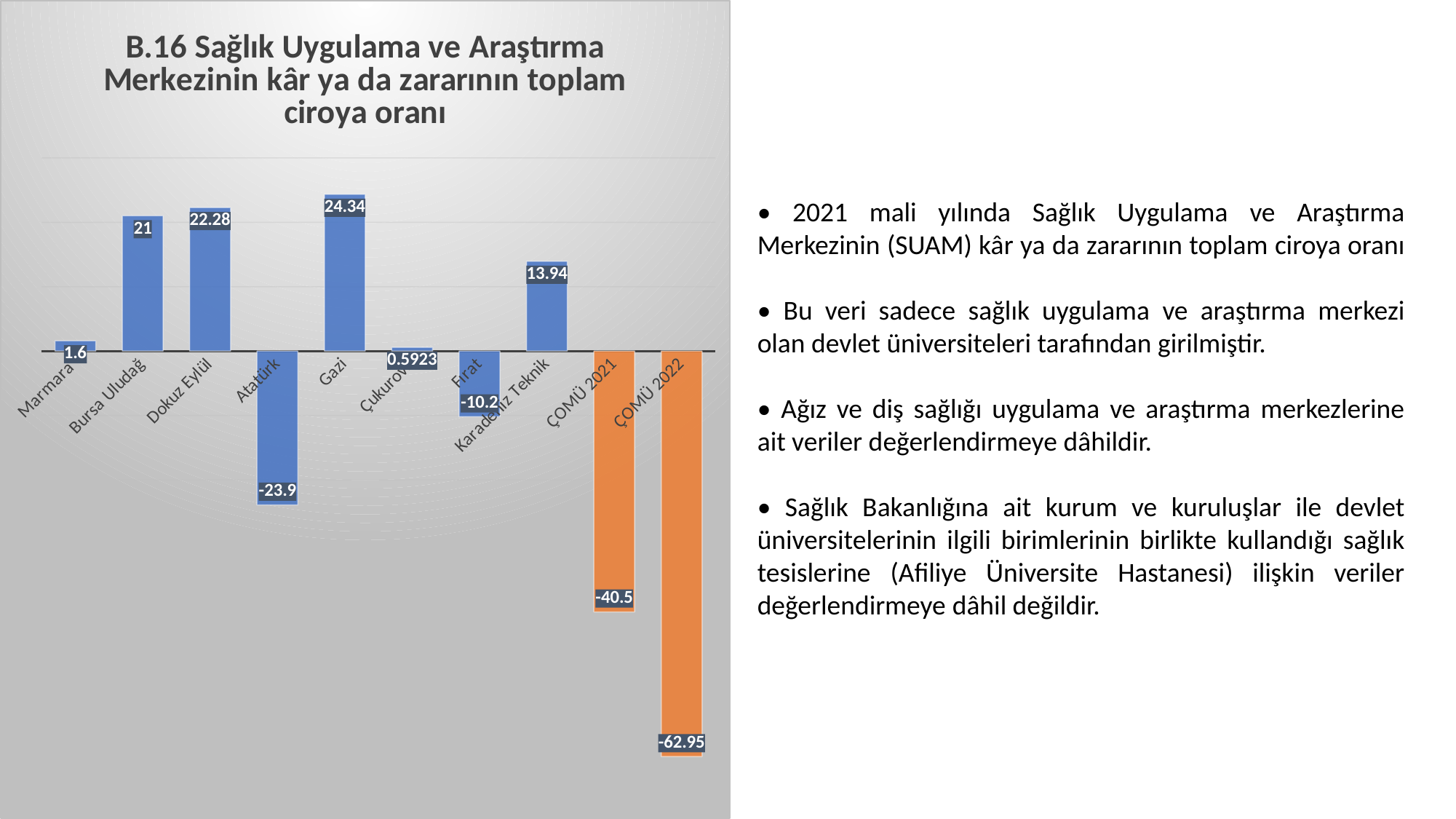
Which category has the highest value? Gazi How many categories are shown on the chart? 10 What is the title of the chart? B.16 Sağlık Uygulama ve Araştırma Merkezinin kâr ya da zararının toplam ciroya oranı What is the value for Gazi? 24.34 What is the value for Atatürk? -23.9 What is the value for ÇOMÜ 2022? -62.95 What is the difference between the values for ÇOMÜ 2021 and ÇOMÜ 2022? 22.45 Which is larger, the value for Bursa Uludağ or the value for Karadeniz Teknik? Bursa Uludağ What is the value for Çukurova? 0.5923 What is the difference between the values for Gazi and Dokuz Eylül? 2.06 What kind of chart is shown on the slide? Bar chart Which category has the lowest value? ÇOMÜ 2022